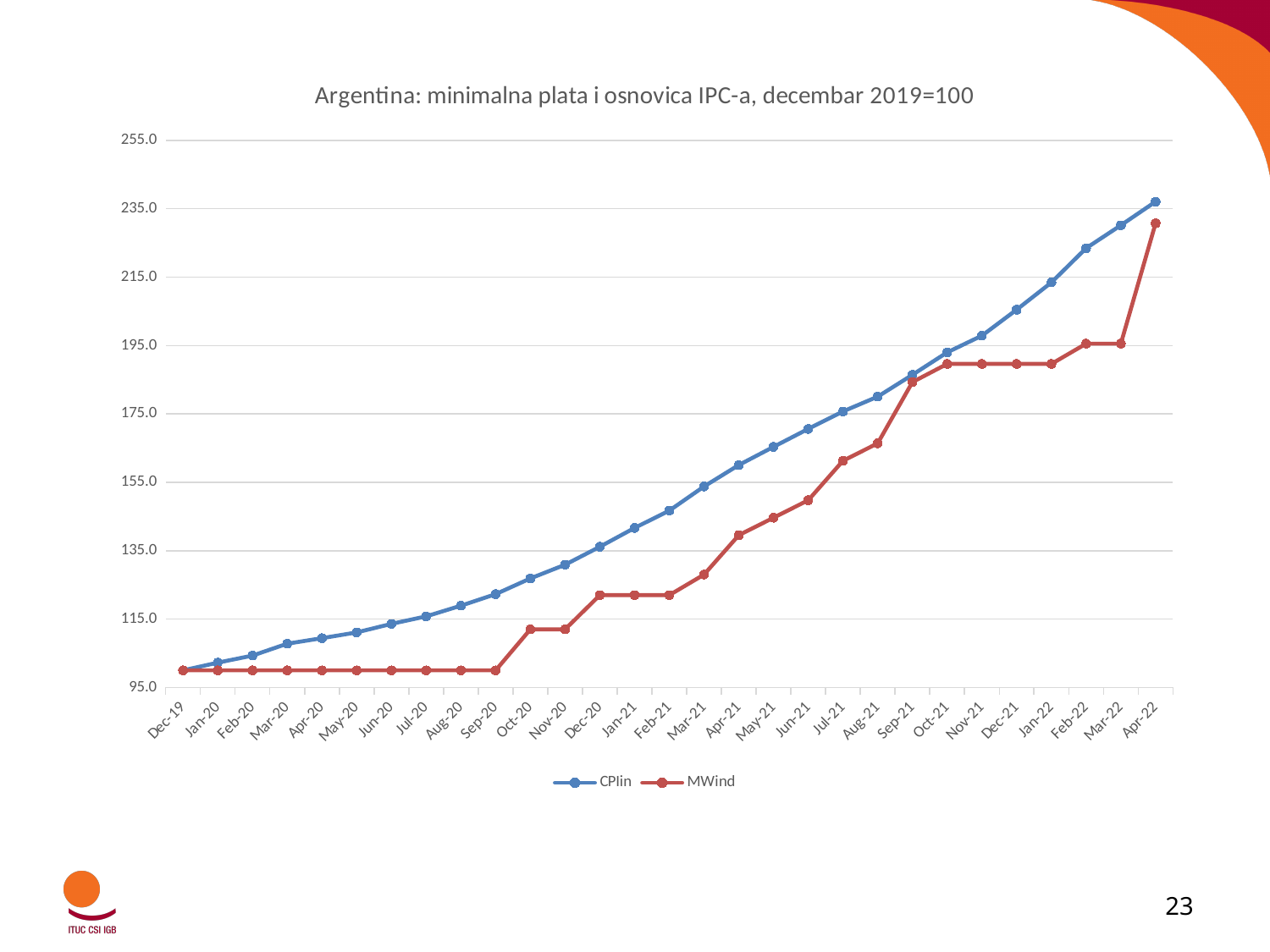
What is the title of the chart? Argentina: minimalna plata i osnovica IPC-a, decembar 2019=100 How many months are plotted along the x axis? 29 Does the CPIin series rise or fall from Dec-19 to Apr-22? rise What are the names of the two series in the legend? CPIin and MWind Which series has the larger value in Apr-21, CPIin or MWind? CPIin In which month does the CPIin series reach its highest value? Apr-22 Is the value of MWind in Jun-21 greater or less than 155? less What kind of chart is shown on the slide? line chart How many series does the legend list? 2 In which month is the CPIin series at its lowest value? Dec-19 Is the value of MWind in Dec-20 greater or less than 115? greater